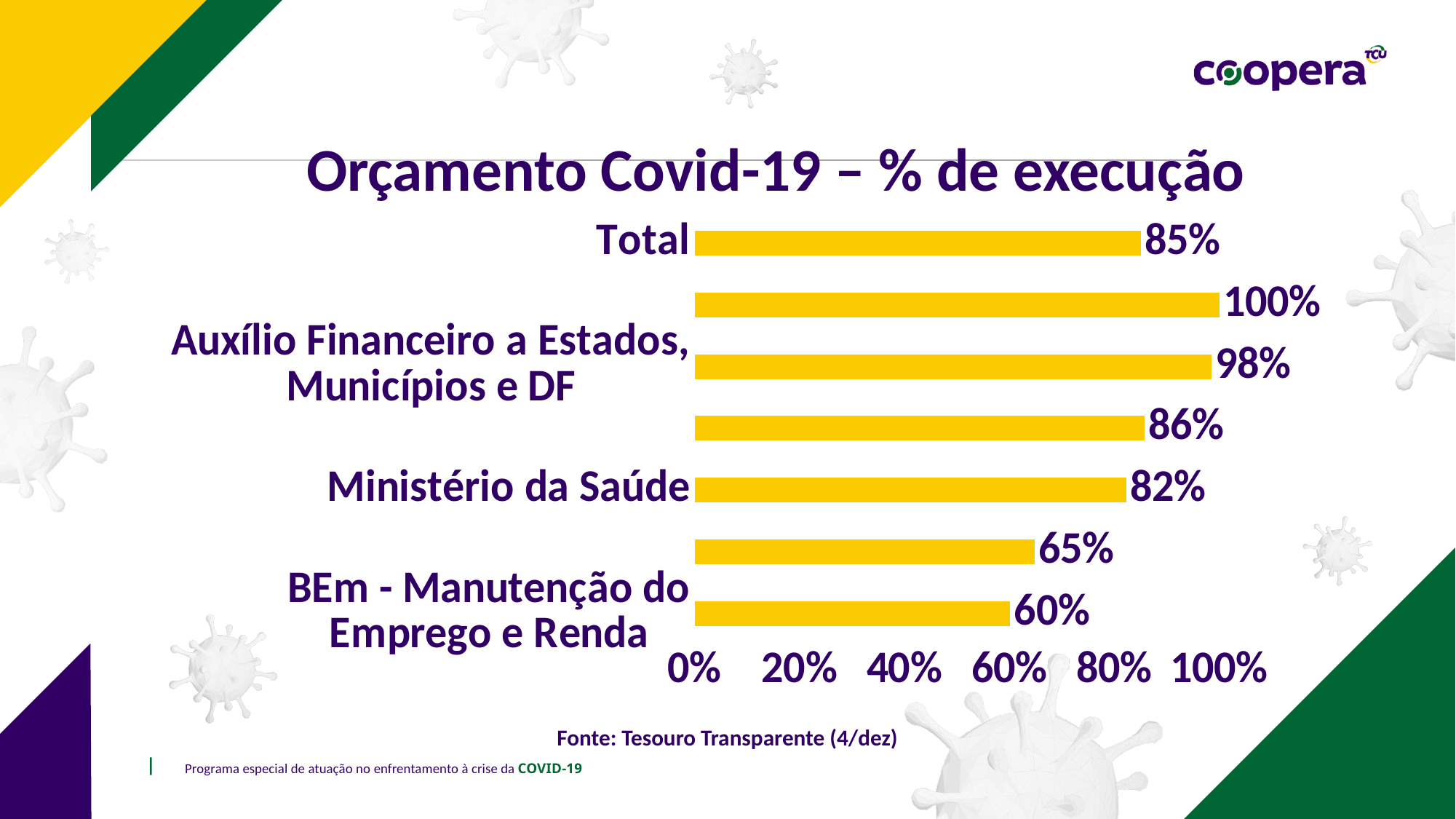
What is the highest tick value shown on the horizontal axis? 100% Is the value for Ministério da Saúde greater or less than 80%? greater What is the title of the chart? Orçamento Covid-19 – % de execução What is the highest value shown on the chart? 100% How many bars are plotted on the chart? 7 What is the value for Ministério da Saúde? 82% What is the value for Total? 85% What kind of chart is shown on the slide? bar chart Which is larger, the value for Total or the value for Ministério da Saúde? Total What is the difference between the value for Total and the value for Ministério da Saúde? 3 percentage points What is the lowest value shown on the chart? 60%